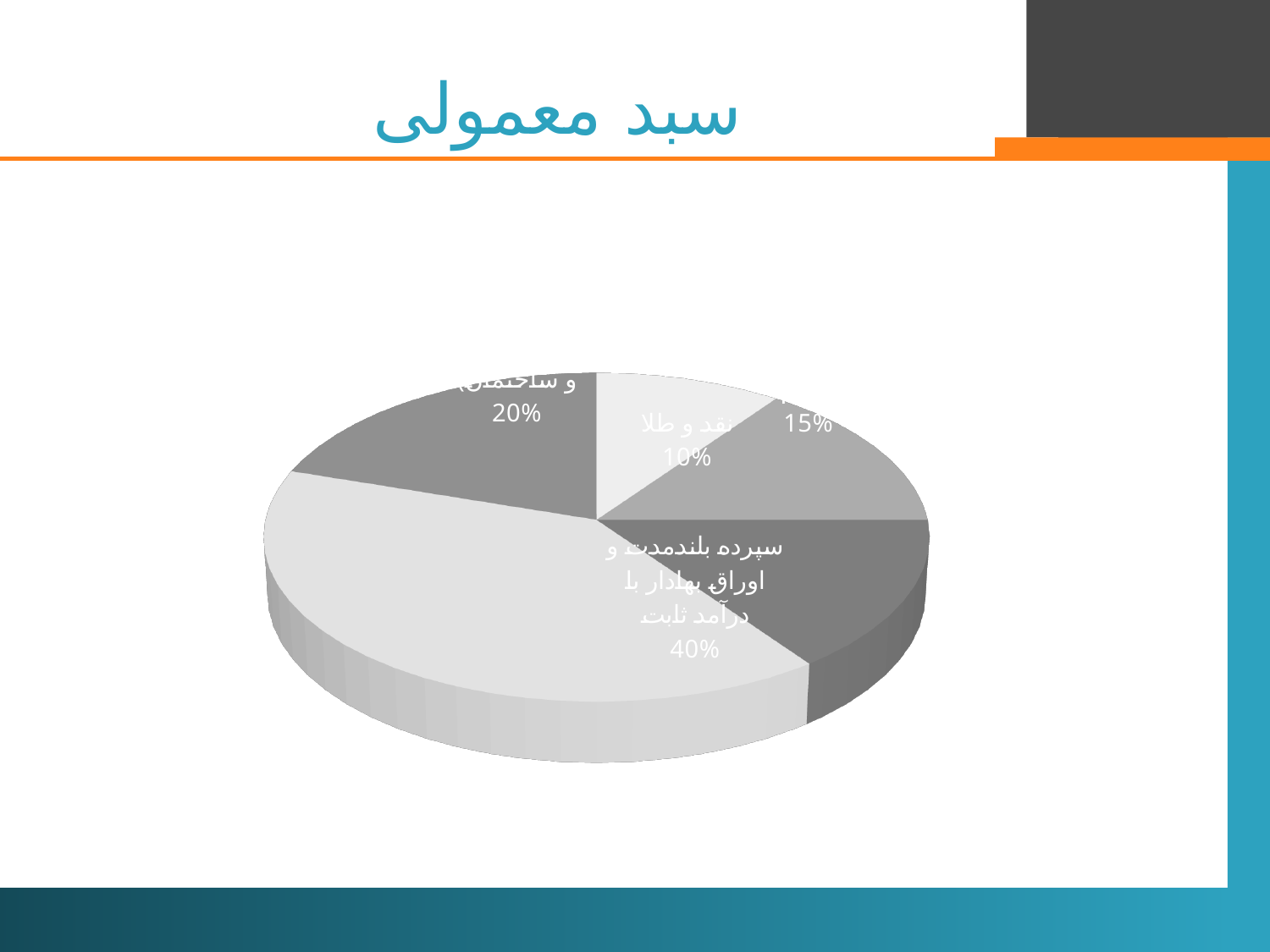
What is the difference between the share of سپرده بلندمدت و اوراق بهادار با درآمد ثابت and the share of نقد و طلا? 30% What share of the pie does نقد و طلا have? 10% Which is larger: the share of نقد و طلا or the share of سپرده بلندمدت و اوراق بهادار با درآمد ثابت? سپرده بلندمدت و اوراق بهادار با درآمد ثابت Is the share of نقد و طلا greater or less than 20%? less What is the title of the chart? سبد معمولی Which slice has the smallest share of the pie? نقد و طلا What share of the pie does سپرده بلندمدت و اوراق بهادار با درآمد ثابت have? 40% Which slice has the largest share of the pie? سپرده بلندمدت و اوراق بهادار با درآمد ثابت What kind of chart is shown on the slide? pie chart How many slices does the pie chart have? 5